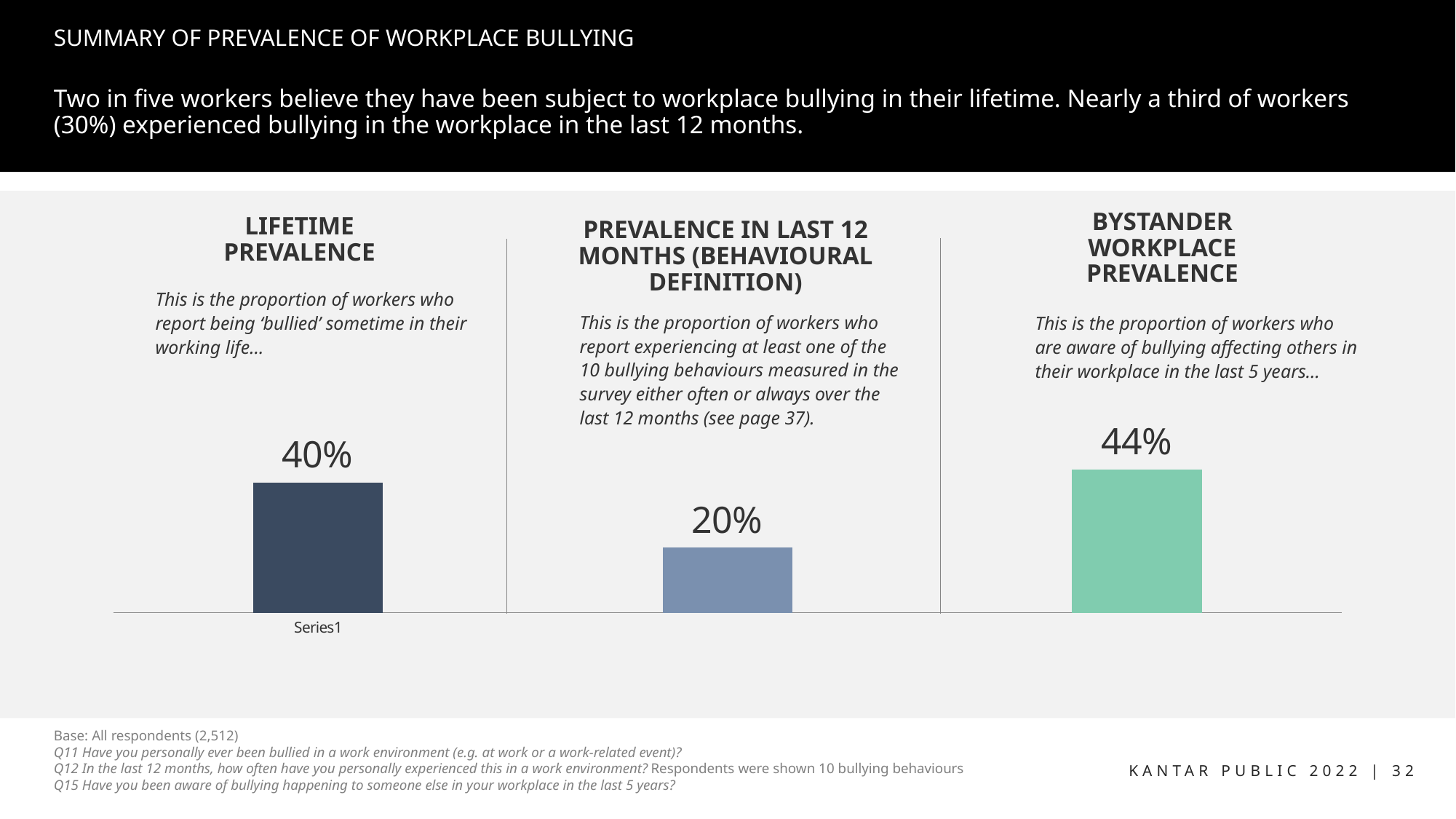
Across the three charts on the slide, which one shows the highest value? Bystander Workplace Prevalence Across the three charts on the slide, which one shows the lowest value? Prevalence in Last 12 Months (Behavioural Definition) What kind of chart is used on the Lifetime Prevalence chart? Bar chart What colour is the bar on the Bystander Workplace Prevalence chart? Green On the Bystander Workplace Prevalence chart, what value is shown on the bar? 44% What is the difference between the value on the Bystander Workplace Prevalence chart and the value on the Lifetime Prevalence chart? 4% On the Prevalence in Last 12 Months (Behavioural Definition) chart, what value is shown on the bar? 20% What is the category label shown under the bar on the Lifetime Prevalence chart? Series1 What is the difference between the value on the Lifetime Prevalence chart and the value on the Prevalence in Last 12 Months chart? 20% Which is larger: the value on the Lifetime Prevalence chart or the value on the Prevalence in Last 12 Months chart? Lifetime Prevalence On the Lifetime Prevalence chart, what value is shown on the bar? 40% How many bars are plotted on the Bystander Workplace Prevalence chart? 1